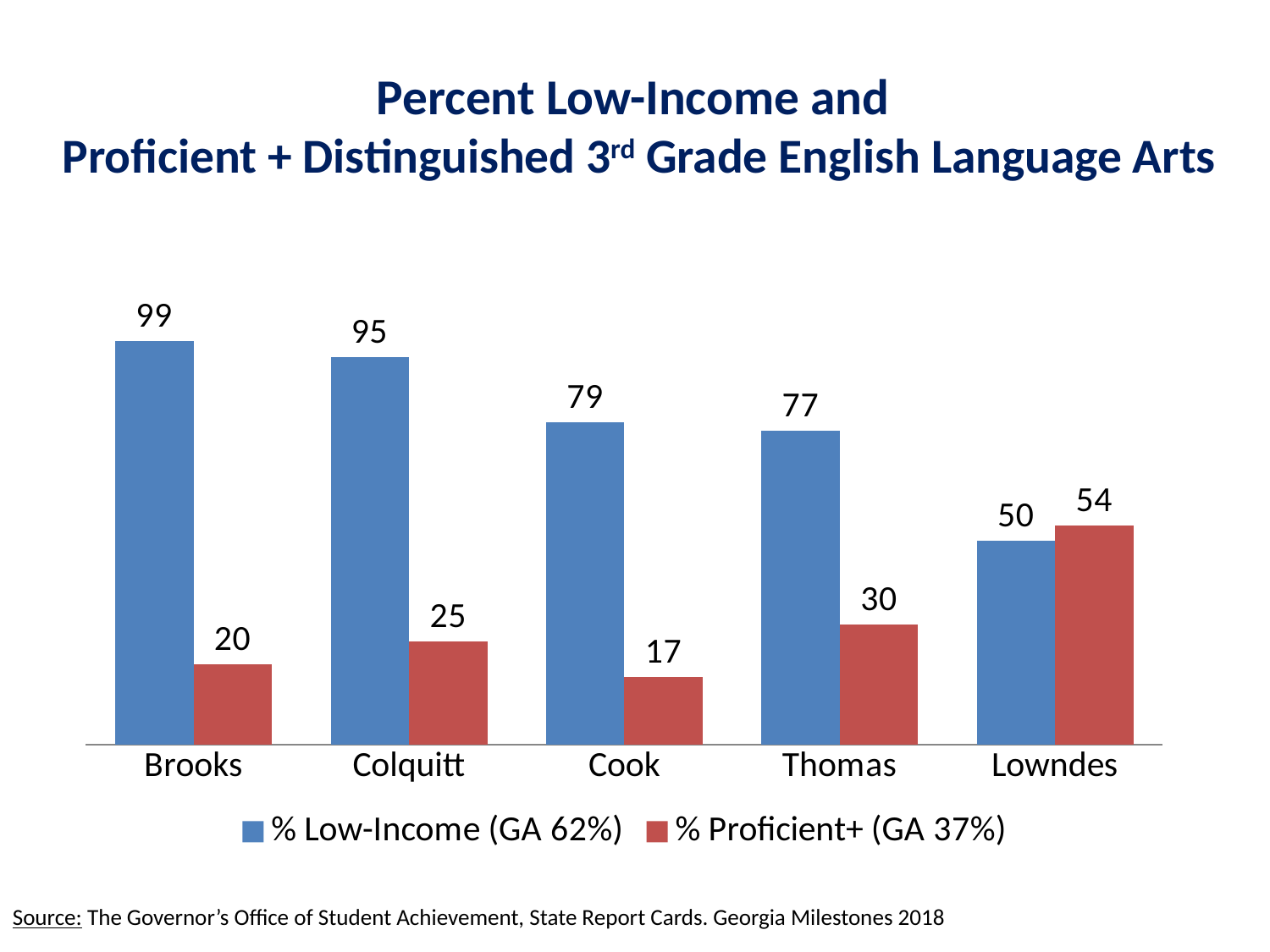
What is the difference between the % Low-Income and % Proficient+ values for Colquitt? 70 Which is larger for Lowndes, the % Low-Income value or the % Proficient+ value? % Proficient+ What Georgia statewide value is given in the legend for % Proficient+? 37% Which county has the lowest % Proficient+ value? Cook What is the % Low-Income value for Brooks? 99 How many series does the legend list? 2 Which county has the highest % Low-Income value? Brooks What is the % Proficient+ value for Thomas? 30 What kind of chart is shown on the slide? Bar chart What is the % Proficient+ value for Lowndes? 54 How many counties are shown on the x axis? 5 Do the % Low-Income values rise or fall from Brooks to Lowndes? Fall